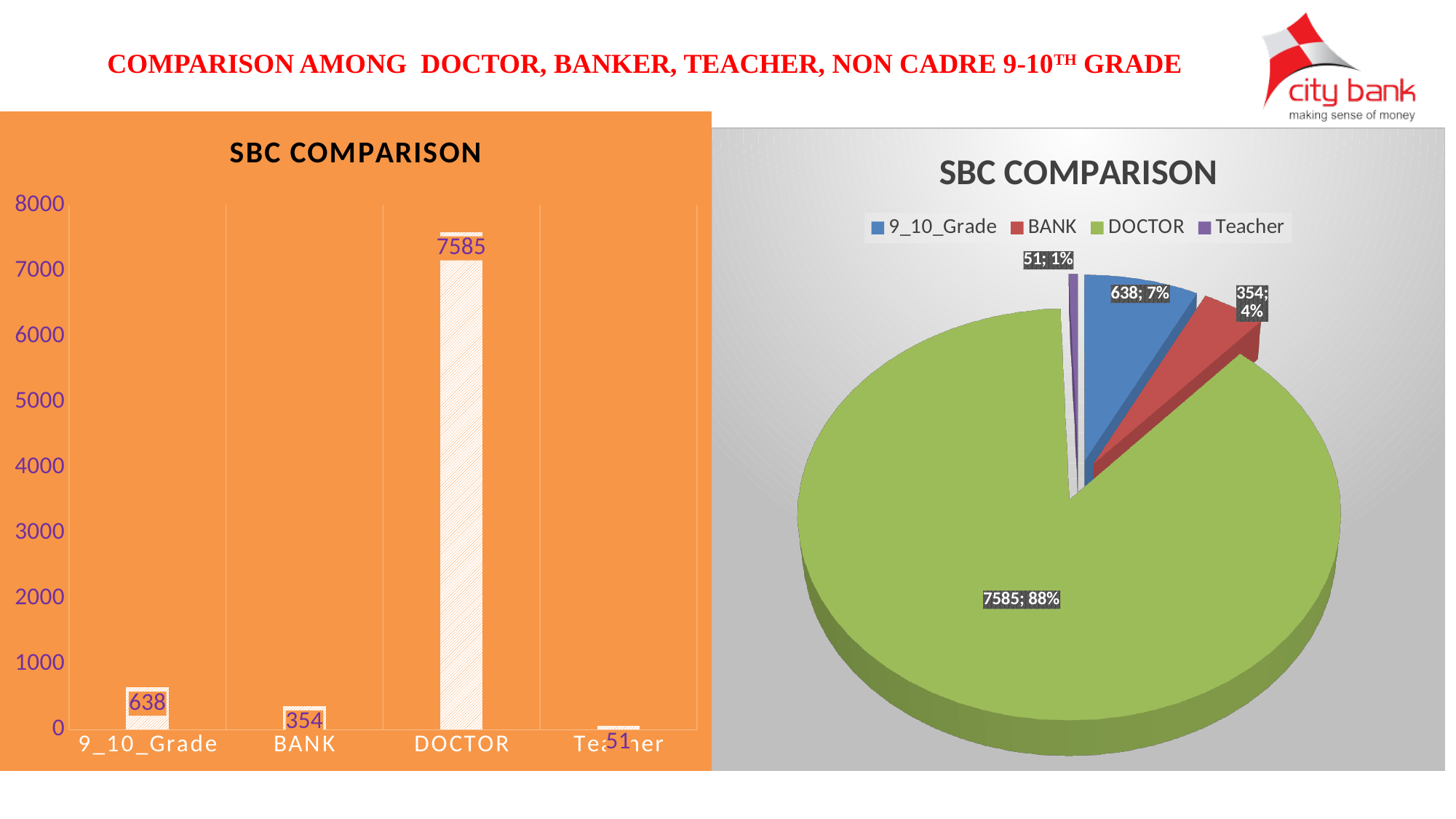
What kind of chart is the chart on the left? Bar chart In the bar chart on the left, what is the value for DOCTOR? 7585 In the pie chart on the right, what value and share are shown for Teacher? 51; 1% In the bar chart on the left, which is larger, 9_10_Grade or BANK? 9_10_Grade In the bar chart on the left, how many categories are shown on the x axis? 4 In the pie chart on the right, what share of the total does DOCTOR represent? 88% In the bar chart on the left, what is the value for BANK? 354 In the bar chart on the left, what is the difference between the DOCTOR and BANK values? 7231 In the bar chart on the left, what is the value for 9_10_Grade? 638 How many series does the legend of the pie chart on the right list? 4 In the bar chart on the left, which category has the highest value? DOCTOR In the bar chart on the left, which category has the lowest value? Teacher